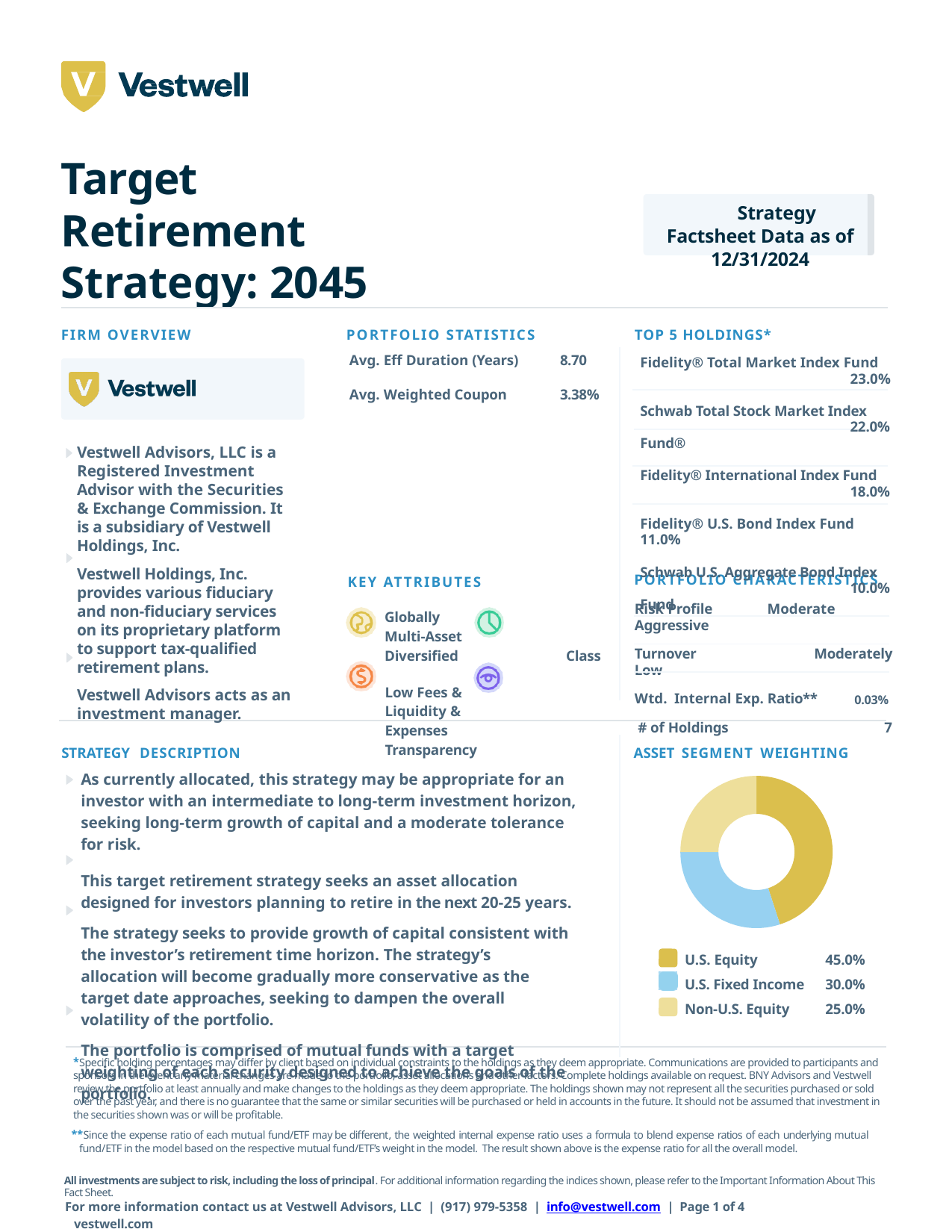
Which segment is the largest in the Asset Segment Weighting chart? U.S. Equity In the Asset Segment Weighting chart, what is the value for U.S. Equity? 45.0% What kind of chart is shown under Asset Segment Weighting? Pie chart (donut) What colour represents U.S. Fixed Income in the Asset Segment Weighting chart? Light blue In the Asset Segment Weighting chart, which is larger: U.S. Fixed Income or Non-U.S. Equity? U.S. Fixed Income In the Asset Segment Weighting chart, what is the difference between U.S. Equity and U.S. Fixed Income? 15.0% In the Asset Segment Weighting chart, what is the difference between U.S. Fixed Income and Non-U.S. Equity? 5.0% How many segments does the Asset Segment Weighting chart have? 3 In the Asset Segment Weighting chart, what is the value for Non-U.S. Equity? 25.0% Which segment is the smallest in the Asset Segment Weighting chart? Non-U.S. Equity In the Asset Segment Weighting chart, what share of the total do U.S. Equity and Non-U.S. Equity make up together? 70.0% In the Asset Segment Weighting chart, what is the value for U.S. Fixed Income? 30.0%